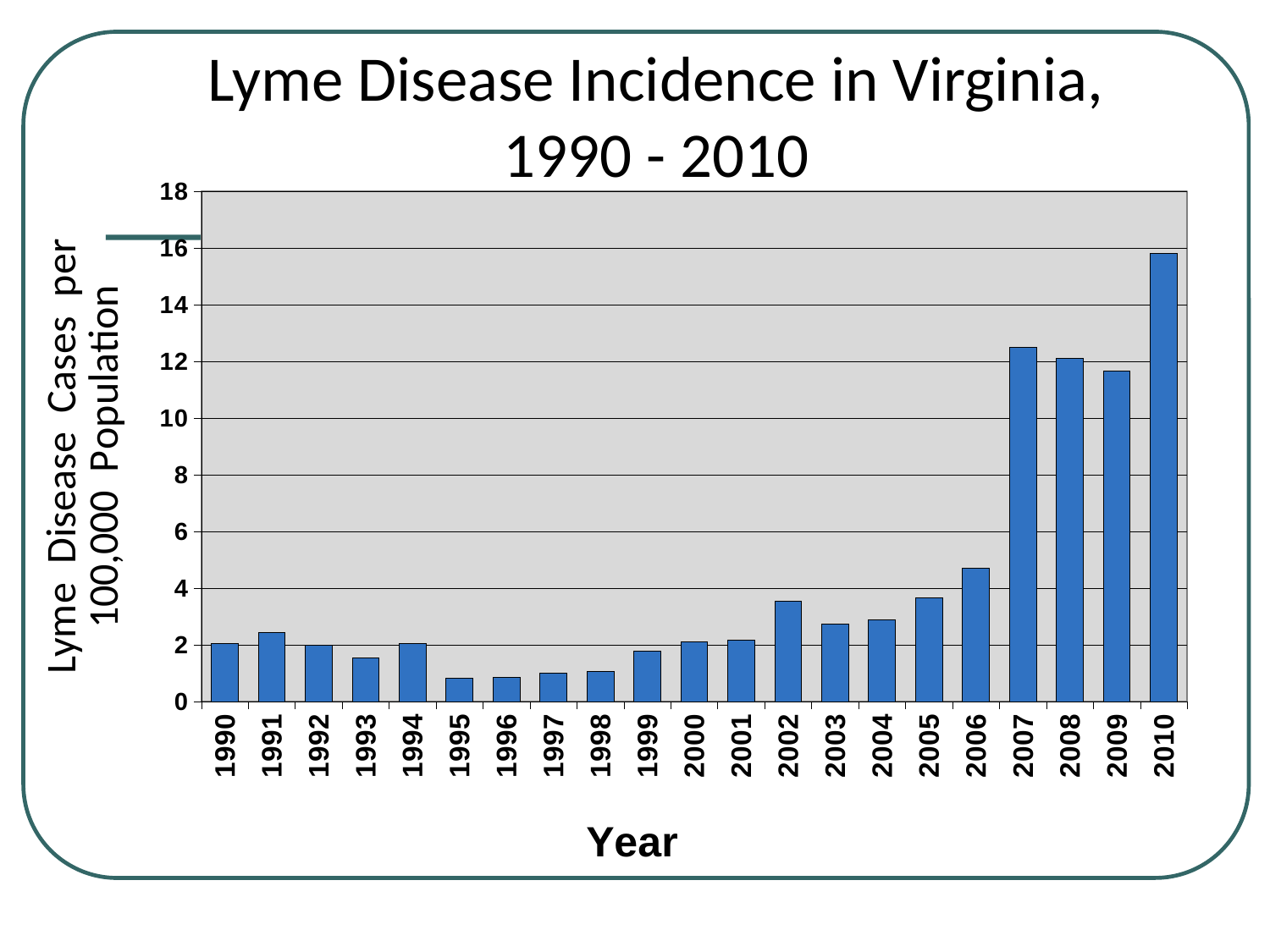
Is the value for 1995 greater or less than 2? less Overall, do the values rise or fall from 1990 to 2010? rise What kind of chart is shown on the slide? bar chart Is the value for 2010 greater or less than 14? greater What is the label of the y axis? Lyme Disease Cases per 100,000 Population How many years are plotted on the x axis? 21 Which year has the highest Lyme disease incidence? 2010 Is the value for 2007 greater or less than 12? greater Which year has the higher incidence, 2007 or 2009? 2007 What is the title of the chart? Lyme Disease Incidence in Virginia, 1990 - 2010